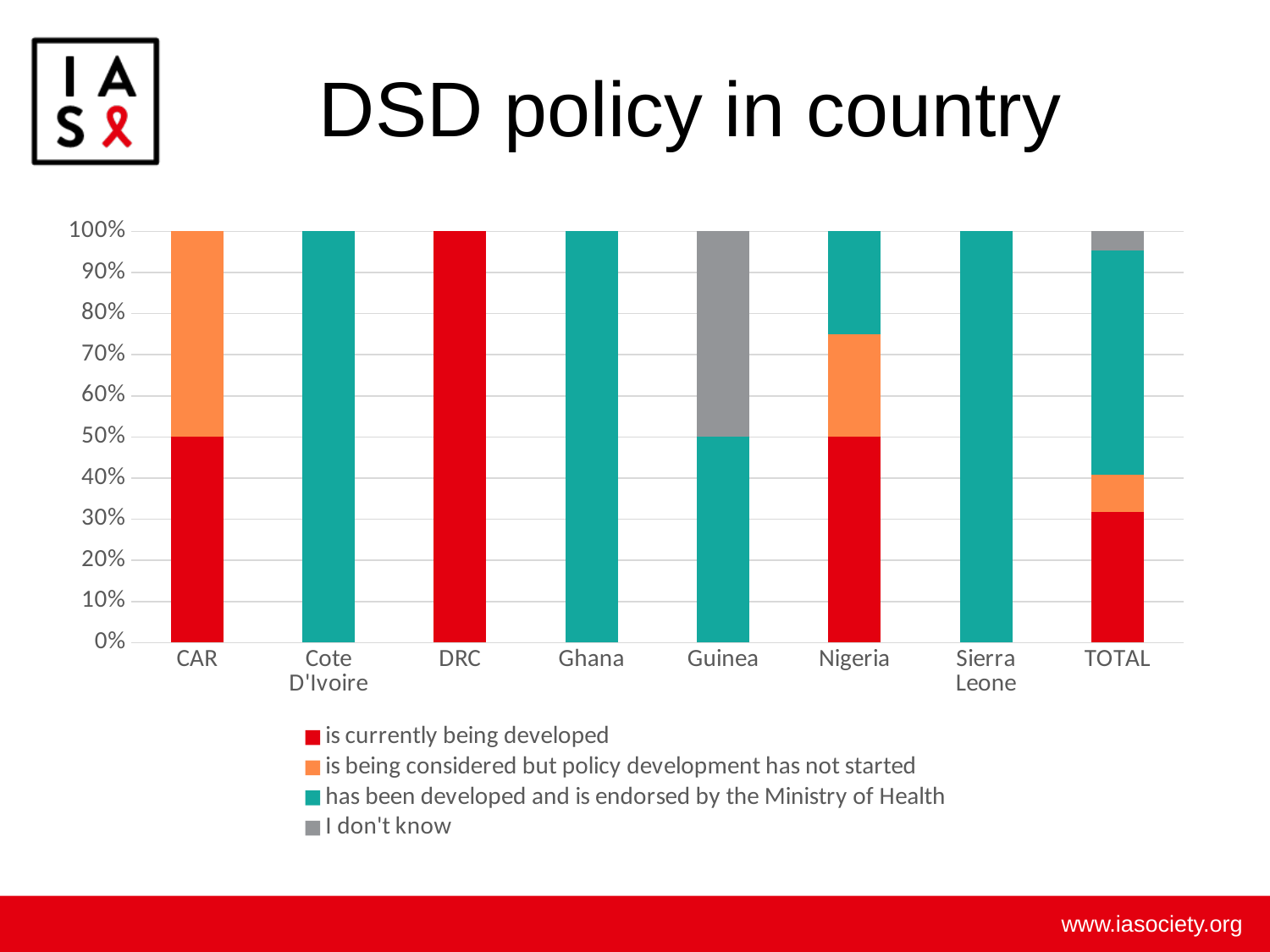
How many series does the legend list? 4 What share of the CAR bar is 'is currently being developed'? 50% How many categories are shown along the x axis? 8 What share of the Nigeria bar is 'is currently being developed'? 50% Which colour represents 'I don't know' in the legend? grey What is the title of the slide? DSD policy in country What share of the Guinea bar is 'I don't know'? 50% Which is larger, the 'is currently being developed' share for CAR or for TOTAL? CAR What kind of chart is shown on the slide? stacked bar chart What share of the Ghana bar is 'has been developed and is endorsed by the Ministry of Health'? 100% Is the 'is currently being developed' share for TOTAL greater or less than 40%? less What share of the DRC bar is 'is currently being developed'? 100%